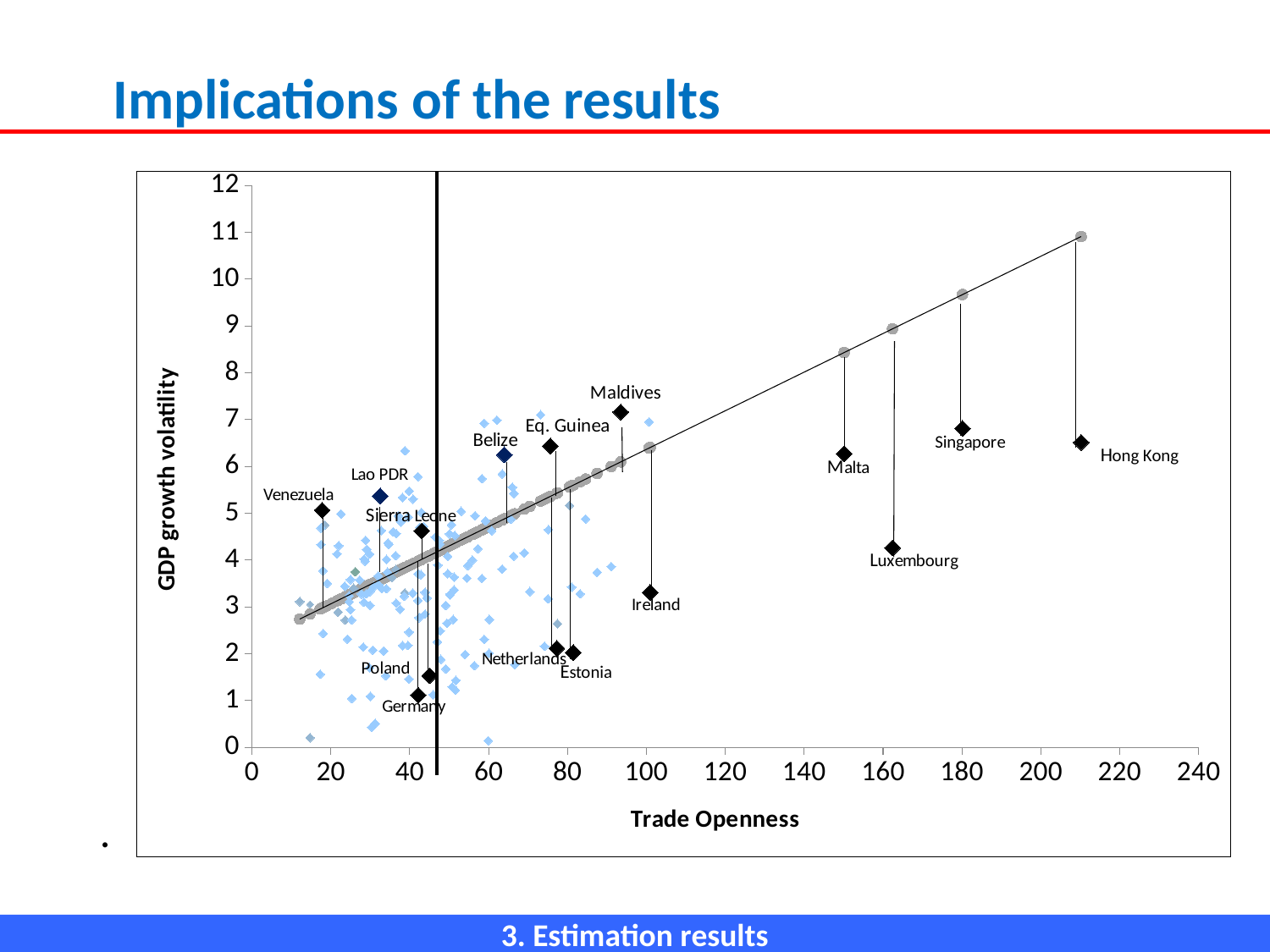
Which has the higher GDP growth volatility, Luxembourg or Singapore? Singapore Does the fitted line rise or fall as trade openness increases? rises Which labelled country has the highest trade openness? Hong Kong Is the trade openness value for Singapore greater or less than 160? greater What is the title of the horizontal axis of the chart? Trade Openness Which has the higher trade openness, Malta or Hong Kong? Hong Kong What is the title of the vertical axis of the chart? GDP growth volatility What kind of chart is shown on the slide? scatter chart Is the trade openness value for Hong Kong greater or less than 200? greater Is the GDP growth volatility value for Maldives greater or less than 6? greater